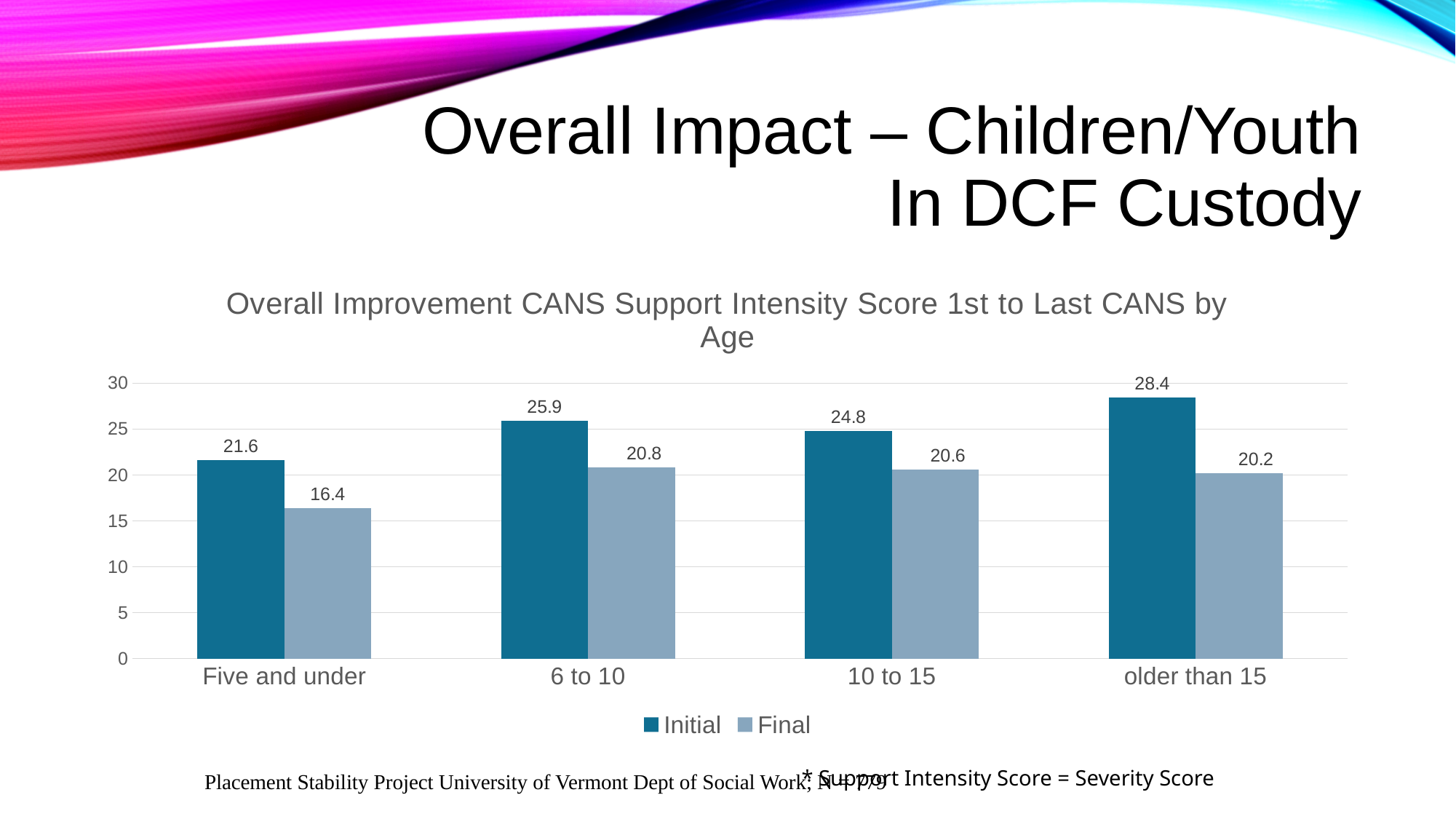
What is the Final value for older than 15? 20.2 Which age group has the highest Initial value? older than 15 What kind of chart is shown on the slide? bar chart Which age group has the lowest Final value? Five and under What is the Initial value for the 6 to 10 age group? 25.9 How many series does the legend list? 2 What is the difference between the Initial and Final values for 10 to 15? 4.2 Which is larger, the Initial value for 6 to 10 or the Initial value for 10 to 15? Initial value for 6 to 10 What is the difference between the Initial and Final values for older than 15? 8.2 Is the Initial value for Five and under greater or less than 20? greater What is the Final value for Five and under? 16.4 How many age groups are shown on the x axis? 4